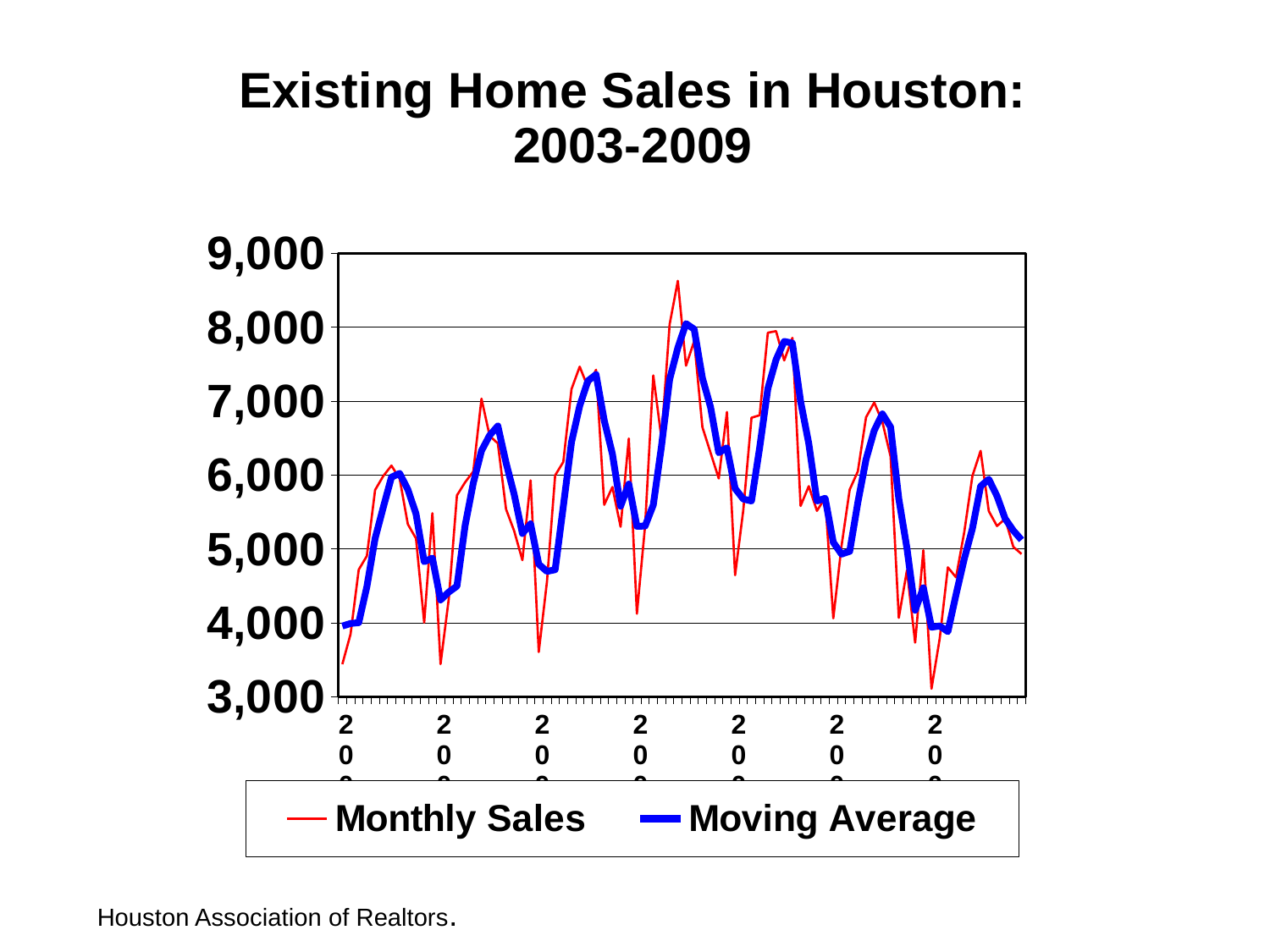
What are the two series named in the legend? Monthly Sales and Moving Average What kind of chart is shown on the slide? line chart Is the highest value reached by the Monthly Sales line greater or less than 8,000? greater How many series does the legend list? 2 Is the Moving Average value at the far left of the chart greater or less than 5,000? less Is the lowest value reached by the Moving Average line greater or less than 5,000? less Which series reaches a higher peak value, Monthly Sales or Moving Average? Monthly Sales Does the Moving Average line rise or fall from the start of the chart to its first peak? rise What is the title of the chart? Existing Home Sales in Houston: 2003-2009